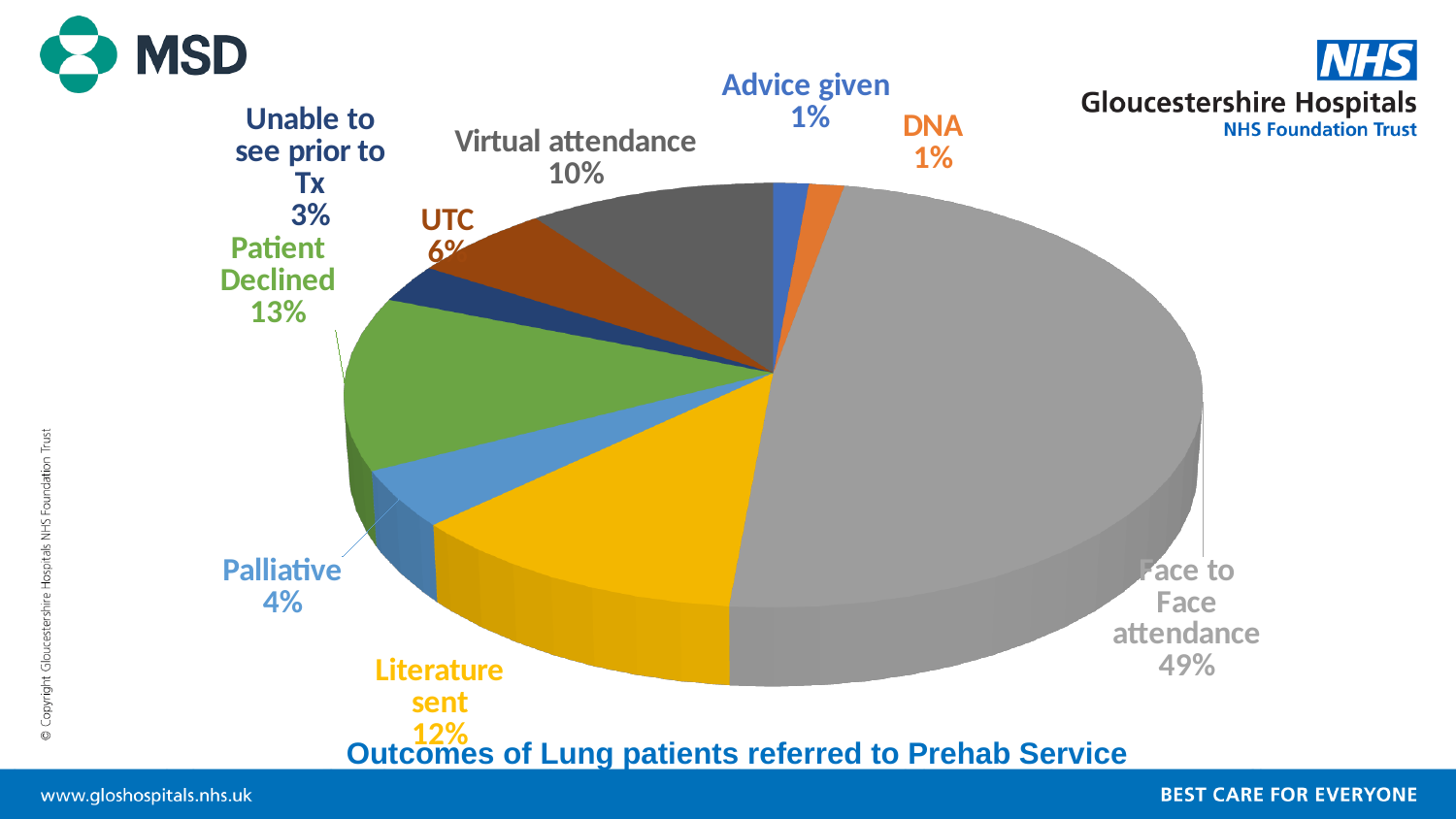
What percentage is shown for Patient Declined? 13% What percentage is shown for Virtual attendance? 10% Which is larger, the share for UTC or the share for Palliative? UTC What kind of chart is shown on the slide? Pie chart What is the title of the chart? Outcomes of Lung patients referred to Prehab Service What percentage is shown for Unable to see prior to Tx? 3% What is the difference in percentage points between Face to Face attendance and Virtual attendance? 39% What percentage is shown for Literature sent? 12% How many categories are shown in the pie chart? 9 What share of the pie is Face to Face attendance? 49% What is the difference in percentage points between Patient Declined and Literature sent? 1% Which category has the largest slice of the pie? Face to Face attendance